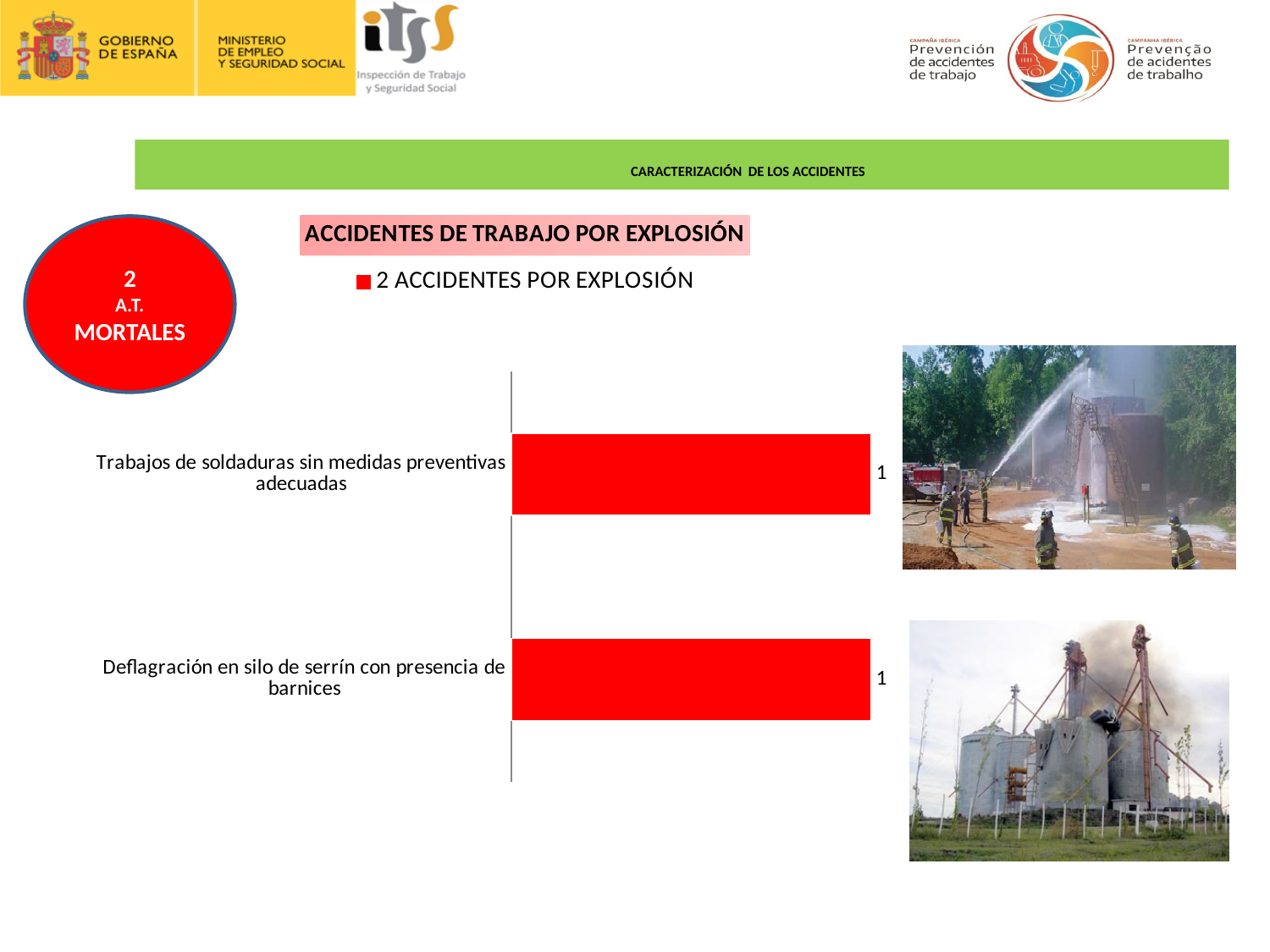
How many series does the legend list? 1 What is the value for "Deflagración en silo de serrín con presencia de barnices"? 1 What colour are the bars in the chart? red What is the value for "Trabajos de soldaduras sin medidas preventivas adecuadas"? 1 What kind of chart is shown on the slide? bar chart What is the total of the two values plotted in the chart? 2 How many categories does the chart show? 2 What is the legend entry of the series in the chart? 2 ACCIDENTES POR EXPLOSIÓN What is the difference between the values for "Trabajos de soldaduras sin medidas preventivas adecuadas" and "Deflagración en silo de serrín con presencia de barnices"? 0